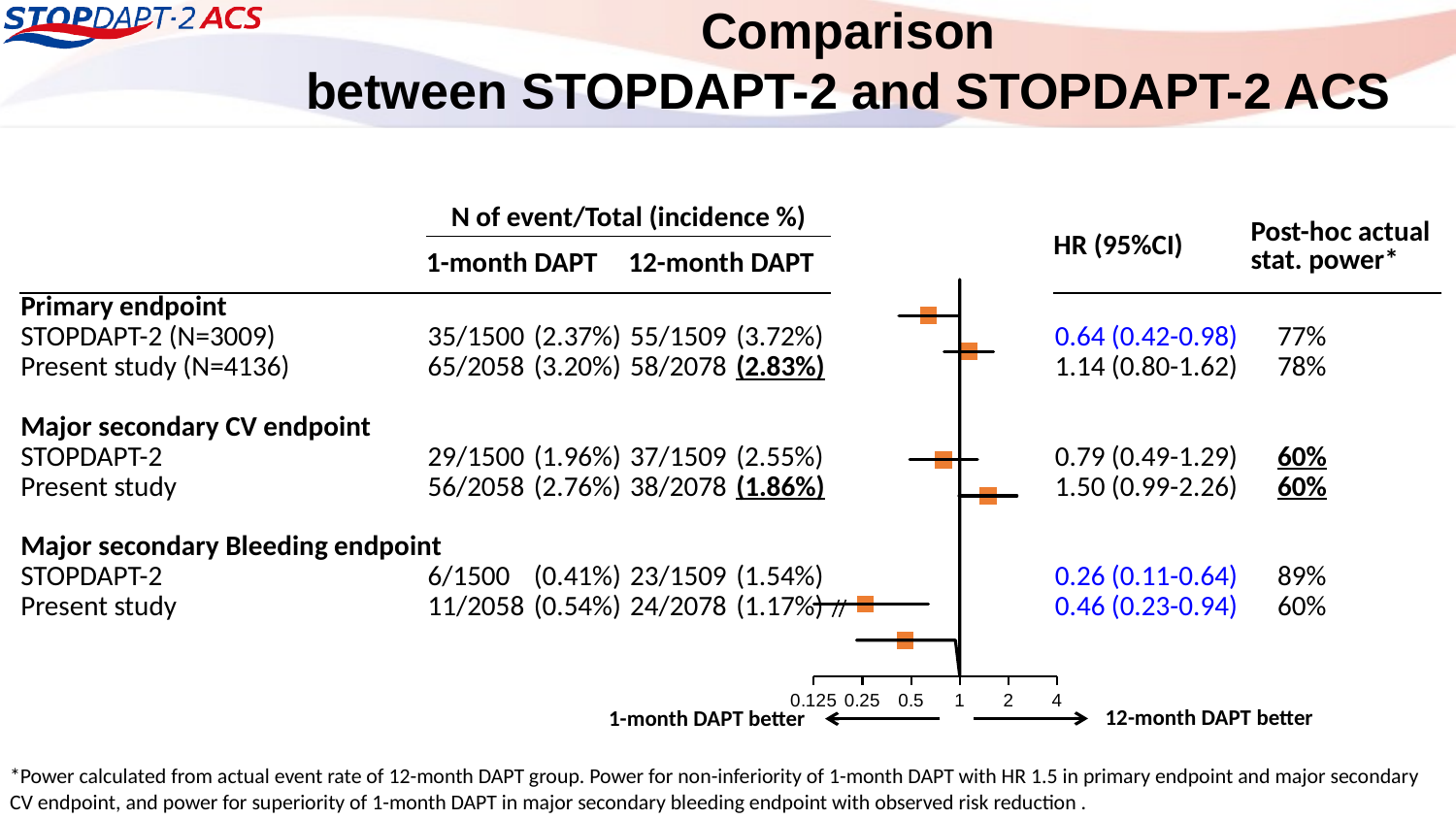
Which row has the highest hazard ratio in the forest plot? Present study, major secondary CV endpoint (1.50) Which row has the lowest hazard ratio in the forest plot? STOPDAPT-2, major secondary bleeding endpoint (0.26) What is the HR (95%CI) for STOPDAPT-2 in the primary endpoint? 0.64 (0.42-0.98) What does the left side of the forest plot's x axis indicate? 1-month DAPT better What is the HR (95%CI) for the present study in the primary endpoint? 1.14 (0.80-1.62) What is the difference in post-hoc actual statistical power between STOPDAPT-2 and the present study in the major secondary bleeding endpoint? 29 percentage points How many point estimates are plotted in the forest plot? 6 In the primary endpoint, which has the larger hazard ratio: STOPDAPT-2 or the present study? Present study What is the post-hoc actual statistical power for STOPDAPT-2 in the major secondary bleeding endpoint? 89% Is the hazard ratio for the present study in the major secondary bleeding endpoint greater or less than 1? less What kind of chart is shown on the slide? Forest plot What is the 12-month DAPT incidence for the present study in the primary endpoint? 2.83%